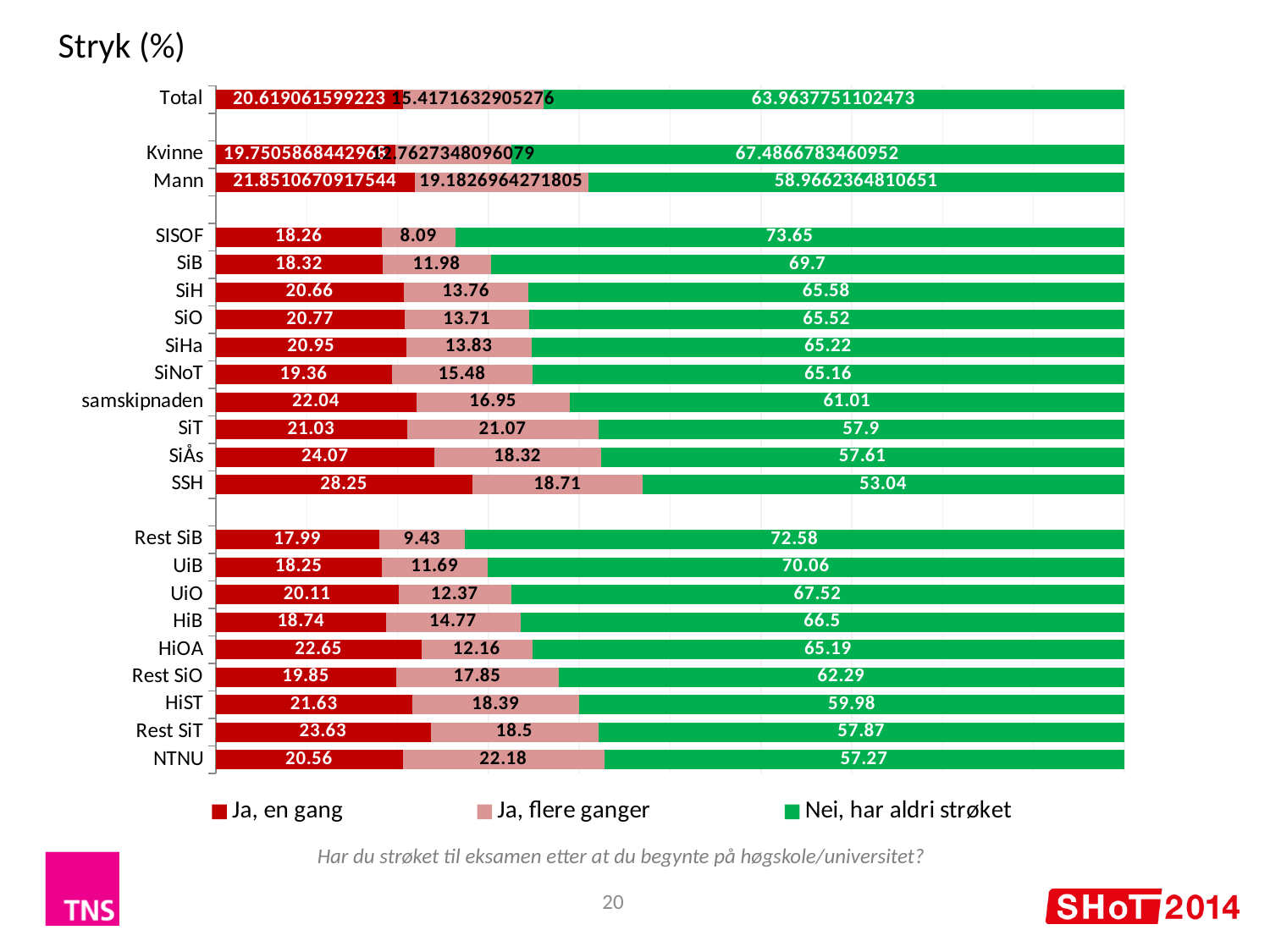
What is the value for Mann in the "Nei, har aldri strøket" series? 58.9662364810651 What is the total of the stacked bar for SiB? 100 Which category has the lowest value in the "Nei, har aldri strøket" series? SSH Which category has the highest value in the "Nei, har aldri strøket" series? SISOF Which category has the highest value in the "Ja, en gang" series? SSH Which has the larger "Ja, en gang" value, SiÅs or SiT? SiÅs What is the difference between the "Nei, har aldri strøket" values for SISOF and SSH? 20.61 What is the title of the chart? Stryk (%) What kind of chart is shown on the slide? Stacked bar chart How many series does the legend list? 3 What is the value for SSH in the "Ja, en gang" series? 28.25 What is the value for NTNU in the "Ja, flere ganger" series? 22.18